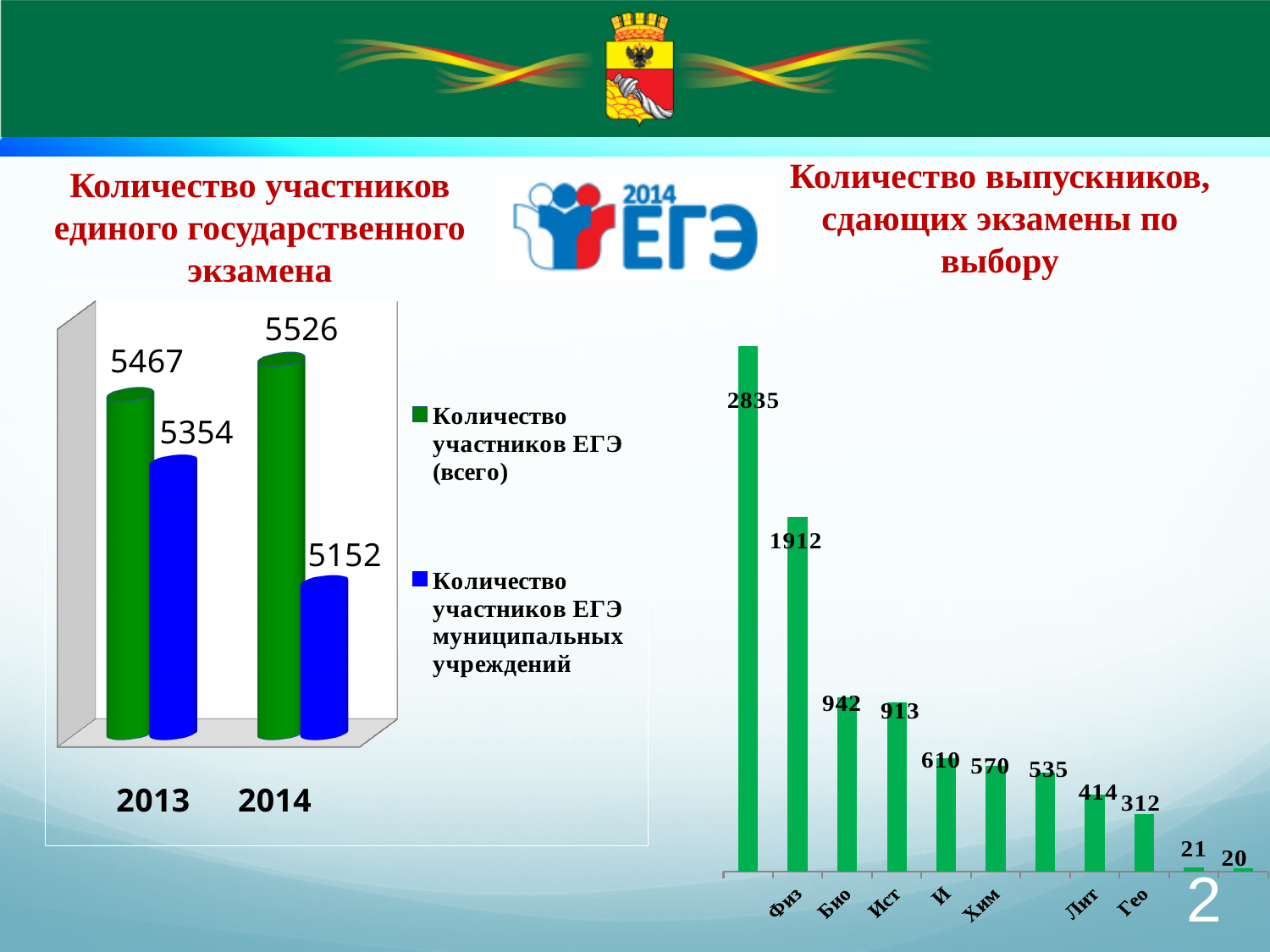
In the left chart (Количество участников единого государственного экзамена), what is the value for Количество участников ЕГЭ муниципальных учреждений in 2013? 5354 In the right chart (Количество выпускников, сдающих экзамены по выбору), how many bars are plotted? 11 In the left chart (Количество участников единого государственного экзамена), what is the difference between the total number of participants in 2014 and in 2013? 59 In the right chart (Количество выпускников, сдающих экзамены по выбору), what is the difference between the values for Физ and Био? 970 In the left chart (Количество участников единого государственного экзамена), which colour represents Количество участников ЕГЭ (всего)? green In the left chart (Количество участников единого государственного экзамена), what is the value for Количество участников ЕГЭ (всего) in 2014? 5526 In the left chart (Количество участников единого государственного экзамена), how many series does the legend list? 2 In the right chart (Количество выпускников, сдающих экзамены по выбору), what is the value for Био? 942 In the right chart (Количество выпускников, сдающих экзамены по выбору), what is the value for Физ? 1912 In the left chart (Количество участников единого государственного экзамена), did the number of participants from municipal institutions rise or fall from 2013 to 2014? fall In the right chart (Количество выпускников, сдающих экзамены по выбору), which is larger, the value for Лит or the value for Гео? Лит